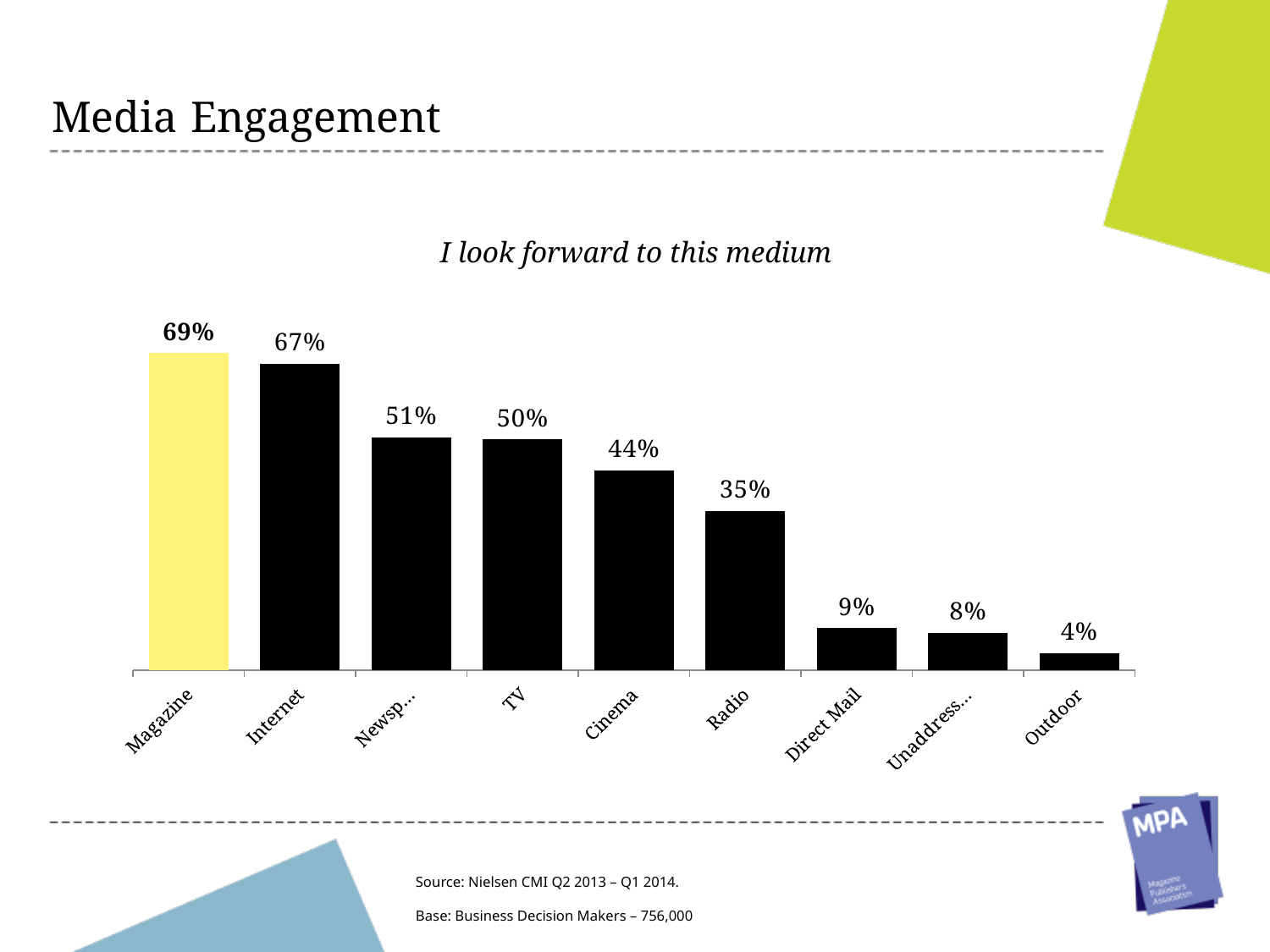
Which category has the lowest value? Outdoor What is the value for Magazine? 69% Which is larger, the value for Cinema or the value for Direct Mail? Cinema What is the difference between the values for Magazine and Internet? 2% What kind of chart is shown on the slide? Bar chart What is the difference between the values for TV and Radio? 15% What is the value for Radio? 35% How many categories are shown in the chart? 9 What is the value for Outdoor? 4% Which category has the highest value? Magazine What is the title of the chart? I look forward to this medium What is the value for Cinema? 44%